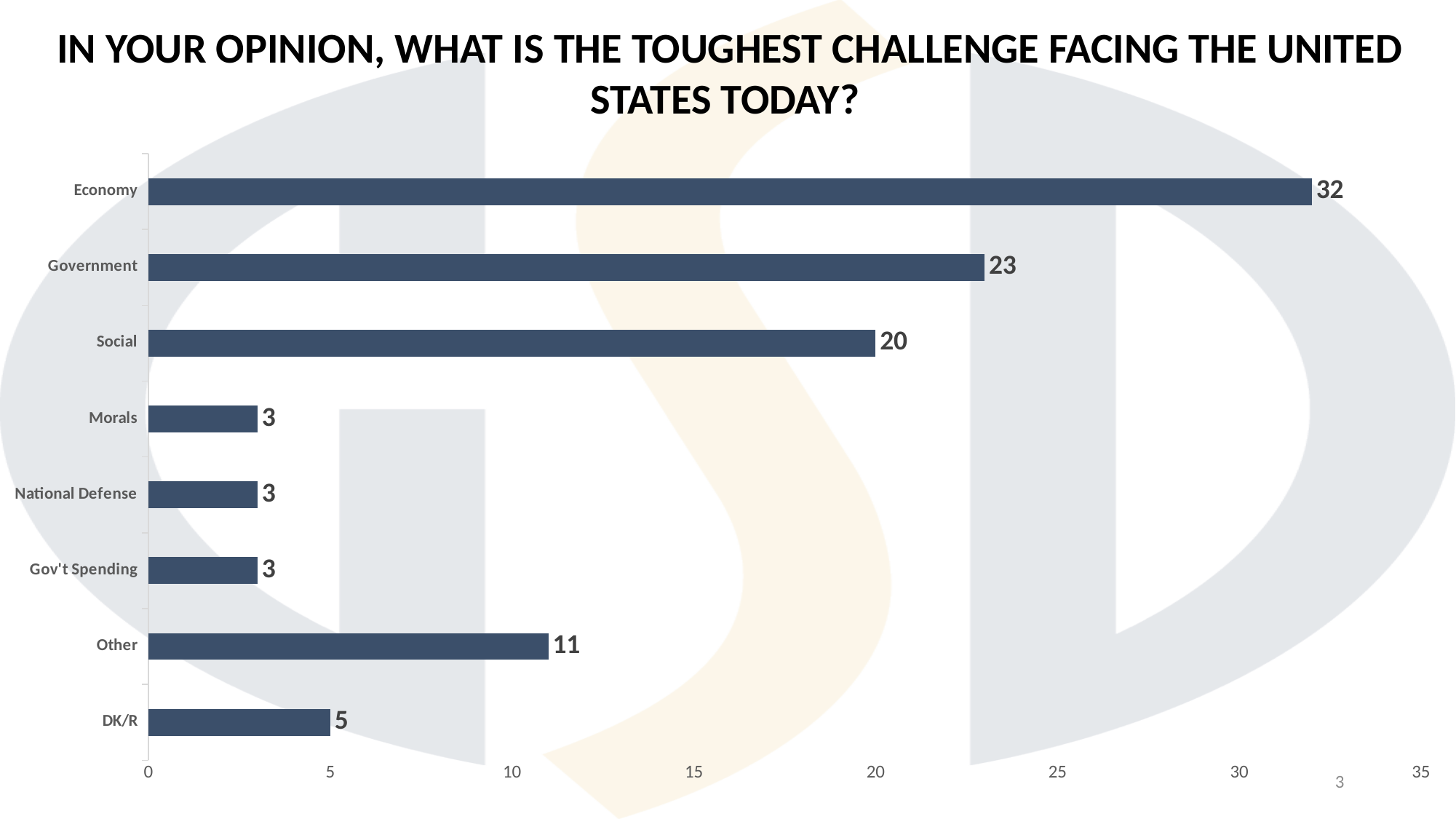
Which category has the highest value? Economy What is the value for Government? 23 What is the title of the slide? IN YOUR OPINION, WHAT IS THE TOUGHEST CHALLENGE FACING THE UNITED STATES TODAY? What is the difference between the values for Social and Other? 9 Is the value for Government greater or less than 20? greater What is the value for Other? 11 How many categories are shown in the chart? 8 What is the value for DK/R? 5 What is the difference between the values for Economy and Government? 9 What kind of chart is shown on the slide? bar chart What is the value for Economy? 32 Which is larger, the value for Social or the value for Other? Social